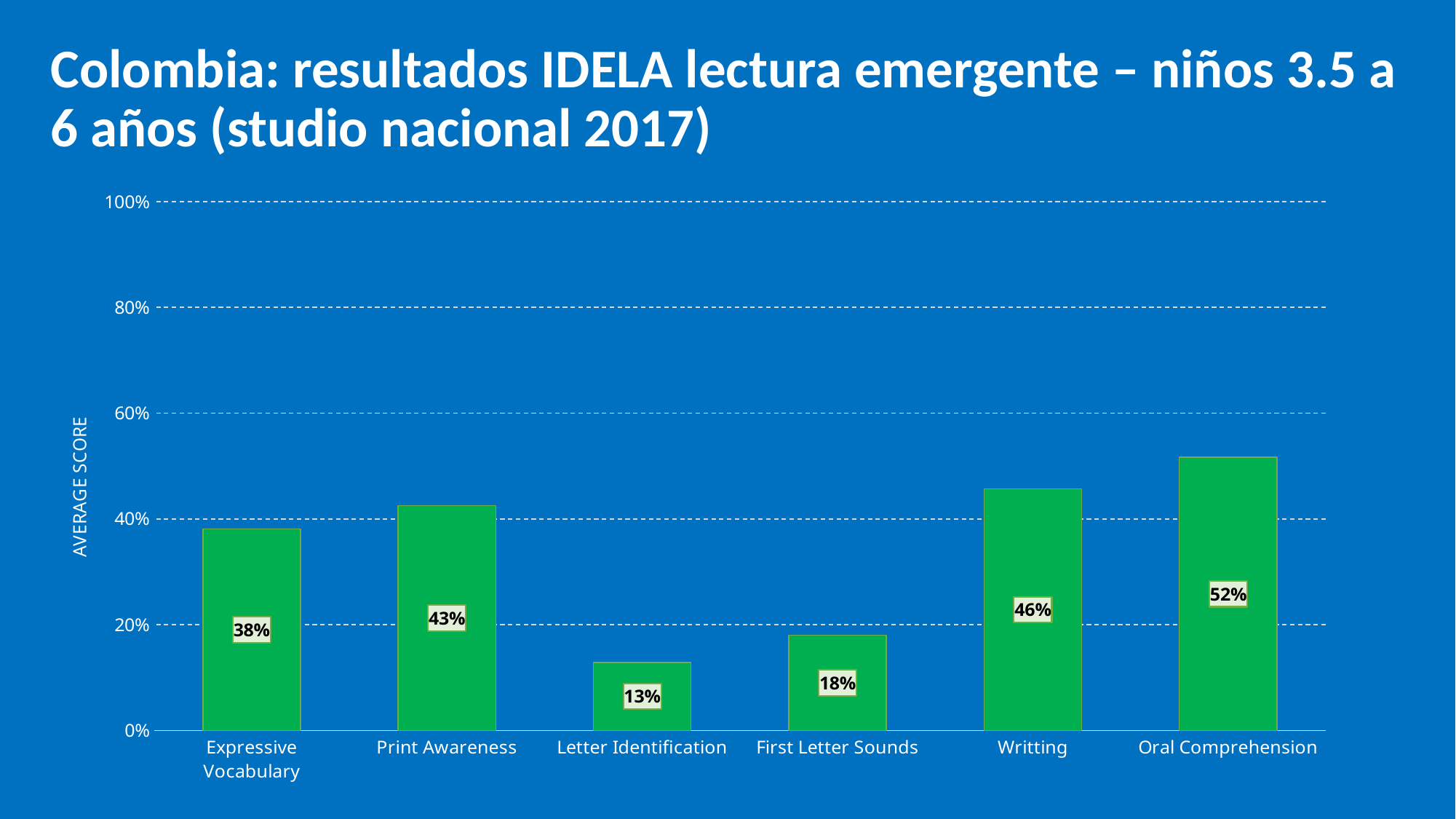
Which category has the highest average score? Oral Comprehension Which category has the lowest average score? Letter Identification How many categories are shown on the x axis? 6 What is the difference between the average scores for Oral Comprehension and Expressive Vocabulary? 14% What is the average score for Letter Identification? 13% Is the value for Expressive Vocabulary greater or less than 40%? less Which has a higher average score, Print Awareness or Writting? Writting What is the average score for Print Awareness? 43% What is the difference between the average scores for First Letter Sounds and Letter Identification? 5% What kind of chart is shown on the slide? Bar chart What is the average score for Writting? 46% What is the label of the vertical axis? AVERAGE SCORE